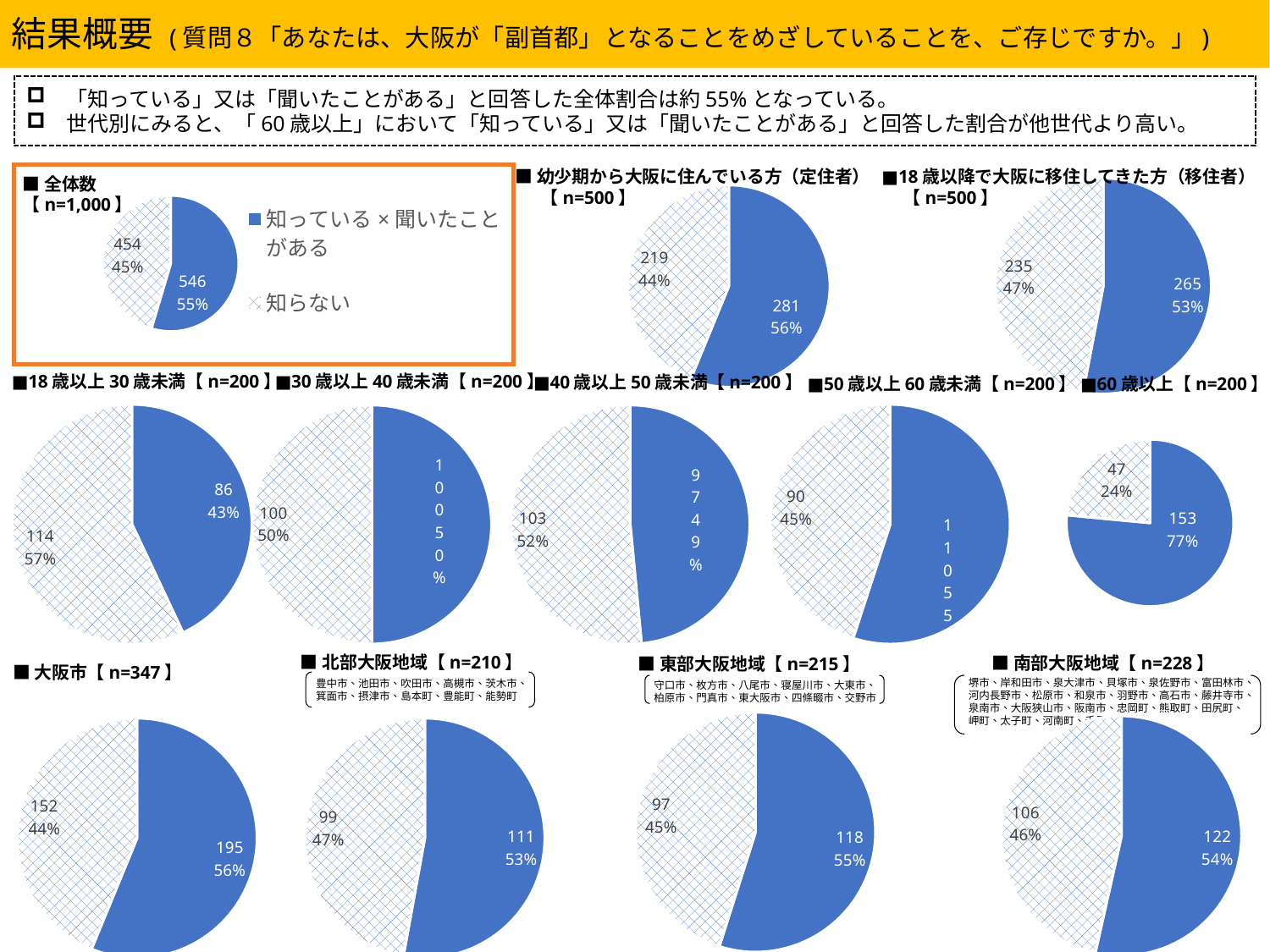
In the 全体数【n=1,000】 pie chart, what percentage share does 知らない have? 45% In the 30歳以上40歳未満【n=200】 pie chart, what percentage share does 知っている×聞いたことがある have? 50% In the 18歳以降で大阪に移住してきた方（移住者）【n=500】 pie chart, how many respondents answered 知っている×聞いたことがある? 265 What type of chart is used for the 60歳以上【n=200】 data? Pie chart In the 60歳以上【n=200】 pie chart, what percentage answered 知っている×聞いたことがある? 77% In the 南部大阪地域【n=228】 pie chart, what percentage answered 知っている×聞いたことがある? 54% In the 大阪市【n=347】 pie chart, how many respondents answered 知らない? 152 In the 全体数【n=1,000】 pie chart, how many respondents answered 知っている×聞いたことがある? 546 In the 18歳以上30歳未満【n=200】 pie chart, which slice is larger, 知っている×聞いたことがある or 知らない? 知らない In the 東部大阪地域【n=215】 pie chart, what is the difference between the 知っている×聞いたことがある count and the 知らない count? 21 In the 幼少期から大阪に住んでいる方（定住者）【n=500】 pie chart, what is the difference between the 知っている×聞いたことがある count and the 知らない count? 62 How many entries does the legend in the 全体数 chart list? 2